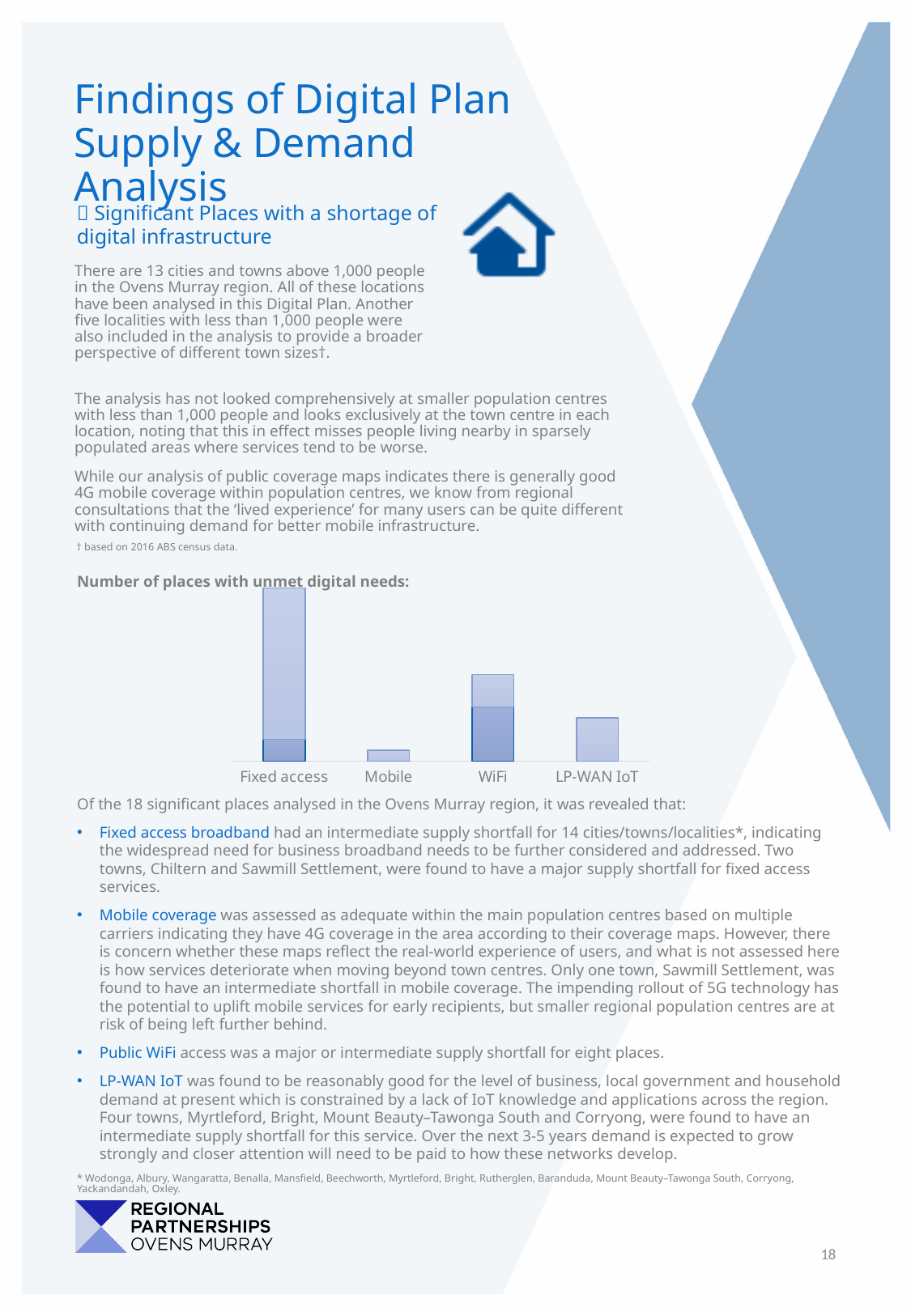
What kind of chart is shown under 'Number of places with unmet digital needs'? Bar chart Which category has the tallest bar in the chart? Fixed access Which bar is taller, Fixed access or WiFi? Fixed access Which bar is taller, Mobile or LP-WAN IoT? LP-WAN IoT Which category has the shortest bar in the chart? Mobile What is the label of the first category on the x axis of the chart? Fixed access How many categories are shown on the x axis of the chart? 4 What is the title of the chart? Number of places with unmet digital needs: Which bar is taller, WiFi or LP-WAN IoT? WiFi